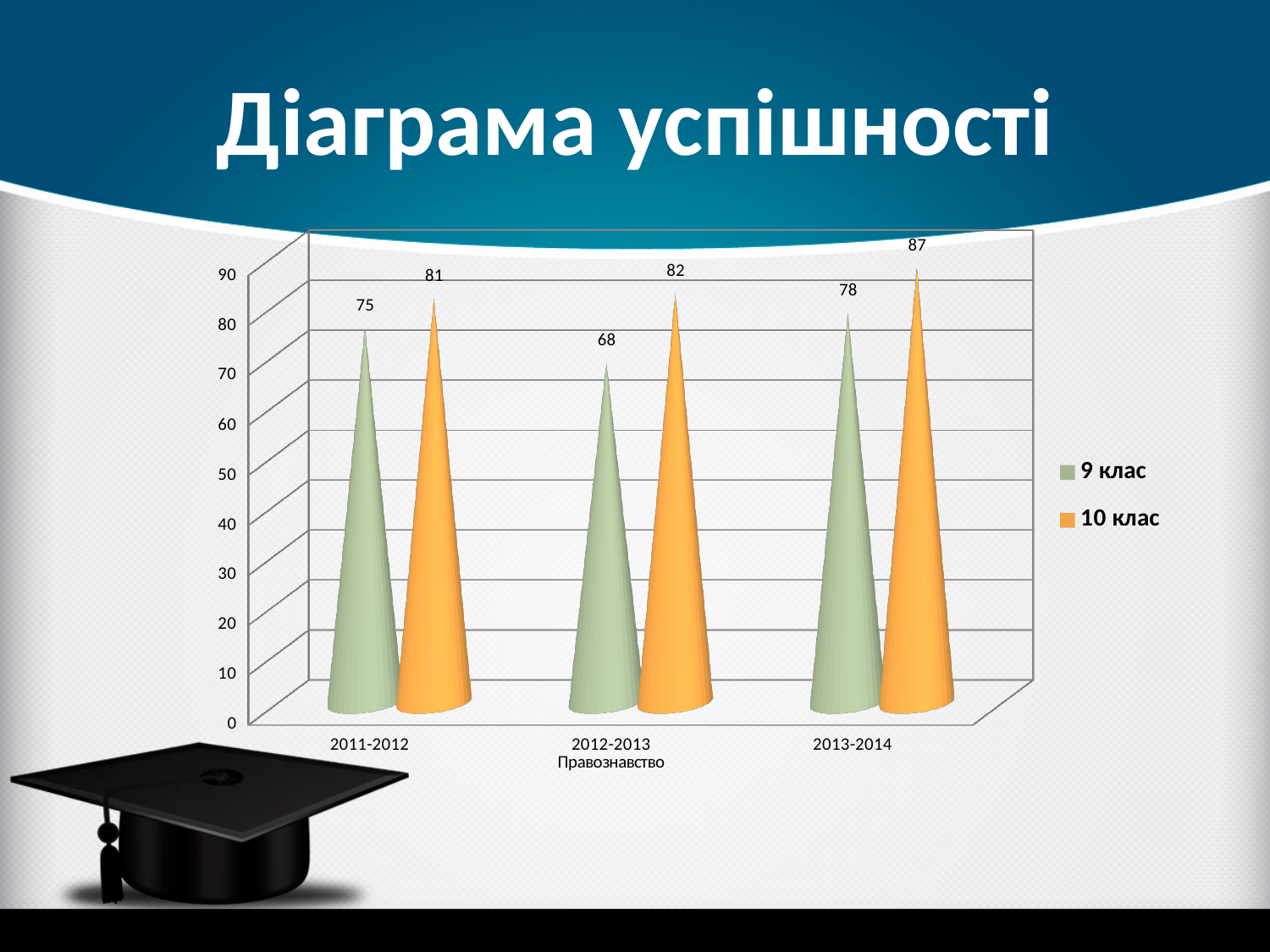
In which year is the value for 9 клас lowest? 2012-2013 In which year is the value for 10 клас highest? 2013-2014 How many year categories are shown on the x axis? 3 What is the value for 9 клас in 2012-2013? 68 What is the value for 10 клас in 2012-2013? 82 What kind of chart is shown on the slide? bar chart What is the value for 10 клас in 2013-2014? 87 What is the difference between 10 клас and 9 клас in 2013-2014? 9 Which is larger in 2011-2012: 9 клас or 10 клас? 10 клас How many series does the legend list? 2 What is the title of the slide? Діаграма успішності What is the value for 9 клас in 2011-2012? 75